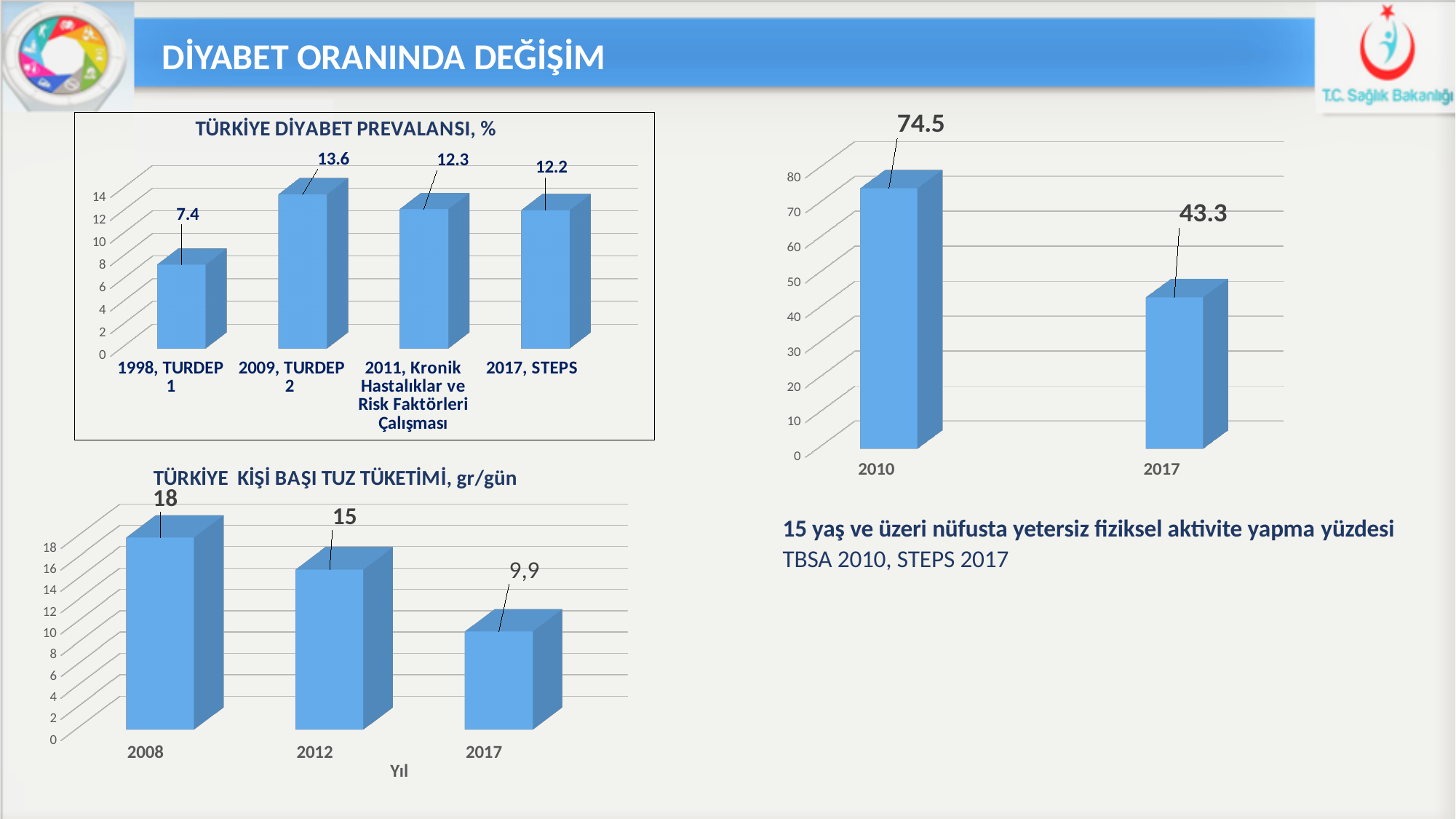
In the 'TÜRKİYE DİYABET PREVALANSI, %' chart, what is the value for 2017, STEPS? 12.2 In the chart on the right (15 yaş ve üzeri nüfusta yetersiz fiziksel aktivite yapma yüzdesi), which year has the lower value? 2017 In the 'TÜRKİYE DİYABET PREVALANSI, %' chart, what is the difference between the 2009, TURDEP 2 value and the 1998, TURDEP 1 value? 6.2 What kind of chart is the chart on the right (15 yaş ve üzeri nüfusta yetersiz fiziksel aktivite yapma yüzdesi)? bar chart In the chart on the right (15 yaş ve üzeri nüfusta yetersiz fiziksel aktivite yapma yüzdesi), what is the value for 2010? 74.5 In the 'TÜRKİYE KİŞİ BAŞI TUZ TÜKETİMİ, gr/gün' chart, what is the label of the x axis? Yıl In the 'TÜRKİYE DİYABET PREVALANSI, %' chart, what is the value for 1998, TURDEP 1? 7.4 In the 'TÜRKİYE DİYABET PREVALANSI, %' chart, which category has the highest value? 2009, TURDEP 2 In the 'TÜRKİYE KİŞİ BAŞI TUZ TÜKETİMİ, gr/gün' chart, what is the value for 2017? 9,9 In the 'TÜRKİYE KİŞİ BAŞI TUZ TÜKETİMİ, gr/gün' chart, what is the difference between the 2008 and 2012 values? 3 In the 'TÜRKİYE KİŞİ BAŞI TUZ TÜKETİMİ, gr/gün' chart, do the values rise or fall from 2008 to 2017? fall In the 'TÜRKİYE DİYABET PREVALANSI, %' chart, how many categories are plotted? 4